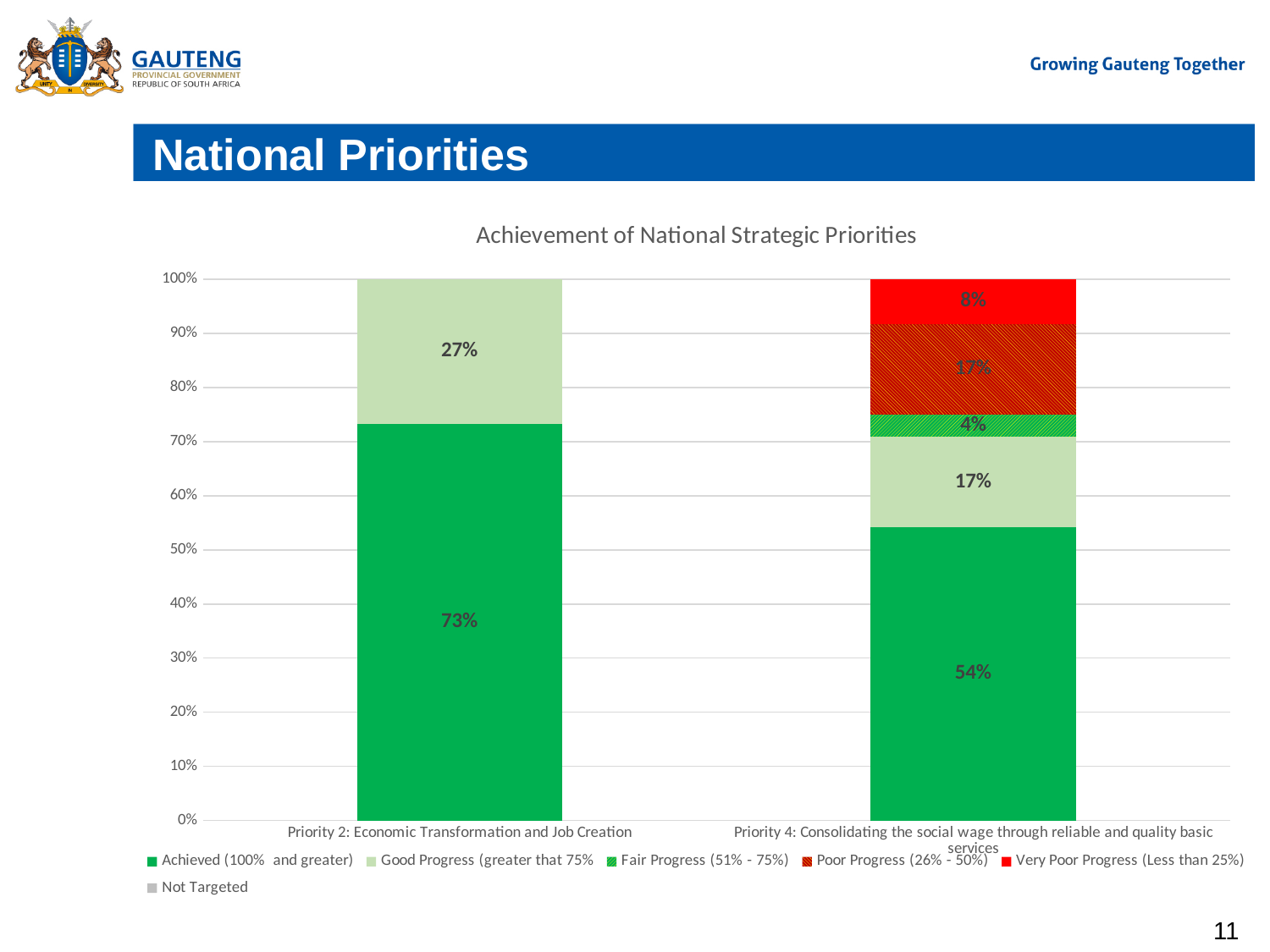
How many categories are shown on the x axis? 2 How many series does the legend list? 6 What kind of chart is shown on the slide? Stacked bar chart What is the Achieved (100% and greater) value for Priority 4: Consolidating the social wage through reliable and quality basic services? 54% What is the Good Progress (greater that 75%) value for Priority 2: Economic Transformation and Job Creation? 27% What is the Very Poor Progress (Less than 25%) value for Priority 4? 8% What is the Achieved (100% and greater) value for Priority 2: Economic Transformation and Job Creation? 73% Which series is shown in the darkest green colour in the legend? Achieved (100% and greater) Which category has the higher Achieved (100% and greater) value, Priority 2 or Priority 4? Priority 2: Economic Transformation and Job Creation What is the Fair Progress (51% - 75%) value for Priority 4? 4% What is the difference between the Achieved values for Priority 2 and Priority 4? 19% What is the title of the chart? Achievement of National Strategic Priorities